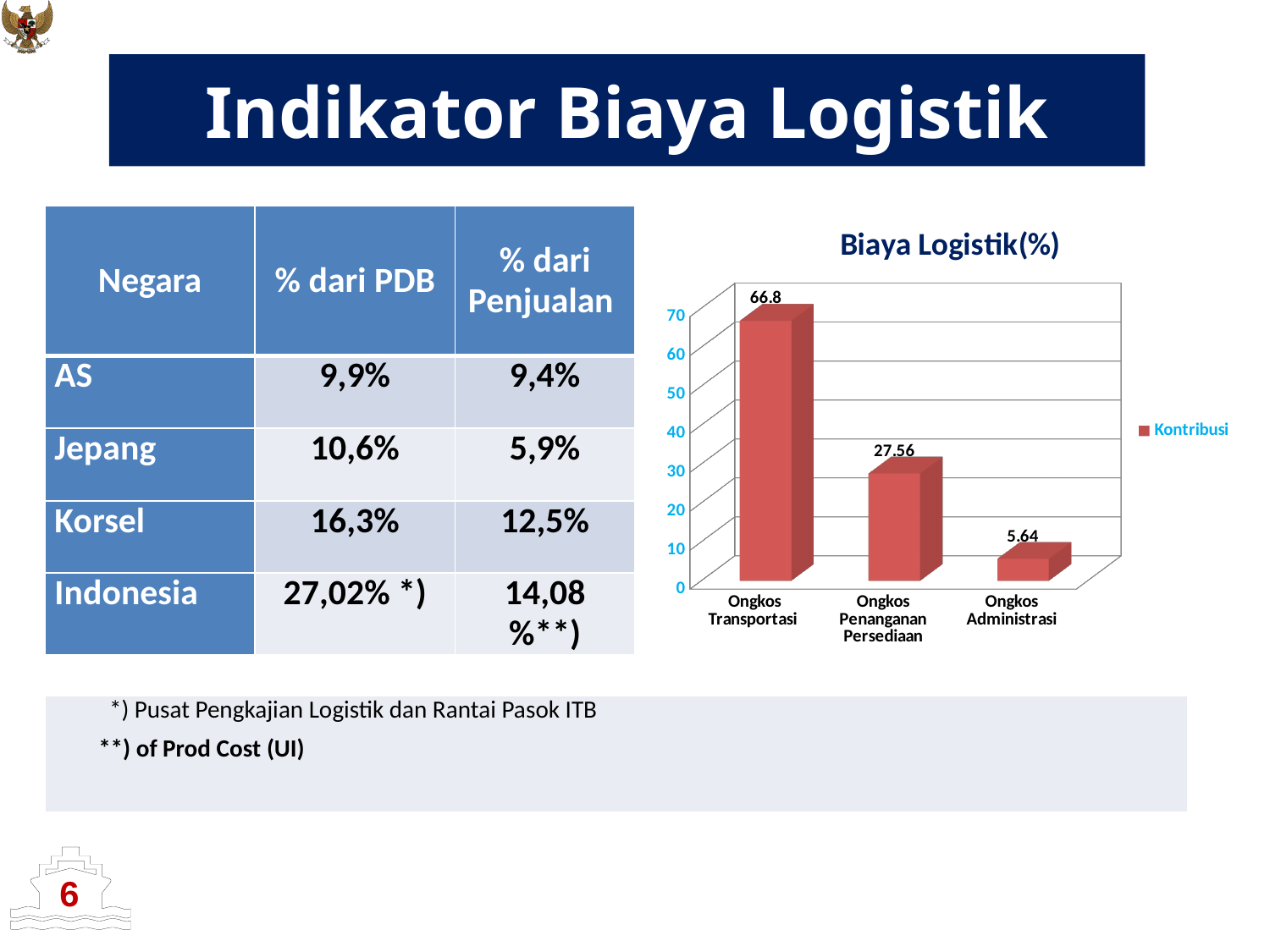
Which is larger in the Biaya Logistik(%) chart: Ongkos Penanganan Persediaan or Ongkos Administrasi? Ongkos Penanganan Persediaan What is the value for Ongkos Penanganan Persediaan in the Biaya Logistik(%) chart? 27.56 How many categories are shown in the Biaya Logistik(%) chart? 3 What is the value for Ongkos Transportasi in the Biaya Logistik(%) chart? 66.8 Is the value for Ongkos Transportasi in the Biaya Logistik(%) chart greater or less than 60? greater Which category has the lowest value in the Biaya Logistik(%) chart? Ongkos Administrasi Which category has the highest value in the Biaya Logistik(%) chart? Ongkos Transportasi What is the difference between the values for Ongkos Penanganan Persediaan and Ongkos Administrasi in the Biaya Logistik(%) chart? 21.92 What is the value for Ongkos Administrasi in the Biaya Logistik(%) chart? 5.64 What is the difference between the values for Ongkos Transportasi and Ongkos Penanganan Persediaan in the Biaya Logistik(%) chart? 39.24 How many series does the legend of the Biaya Logistik(%) chart list? 1 What type of chart is the Biaya Logistik(%) chart? Bar chart